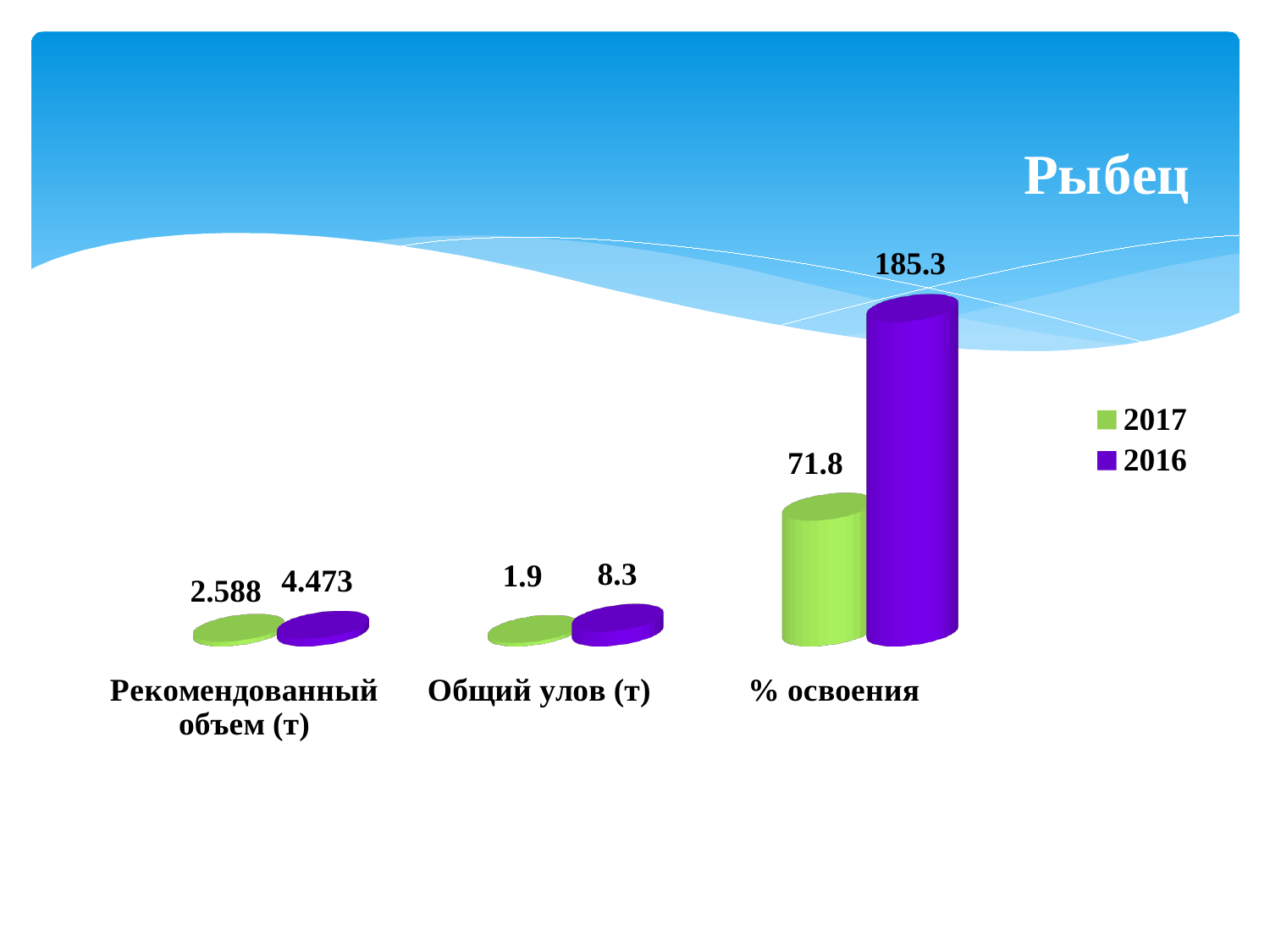
What is the difference between the 2016 and 2017 values in the category "Общий улов (т)"? 6.4 What is the value for 2017 in the category "Рекомендованный объем (т)"? 2.588 Which category has the highest value for the 2016 series? % освоения In the category "Рекомендованный объем (т)", which series has the larger value, 2017 or 2016? 2016 How many categories are shown on the x axis of the chart? 3 What is the value for 2016 in the category "Рекомендованный объем (т)"? 4.473 What is the value for 2016 in the category "% освоения"? 185.3 What type of chart is shown on the slide? Bar chart How many series does the legend list? 2 Which category has the lowest value for the 2017 series? Общий улов (т) What is the difference between the 2016 and 2017 values in the category "% освоения"? 113.5 What is the value for 2017 in the category "Общий улов (т)"? 1.9